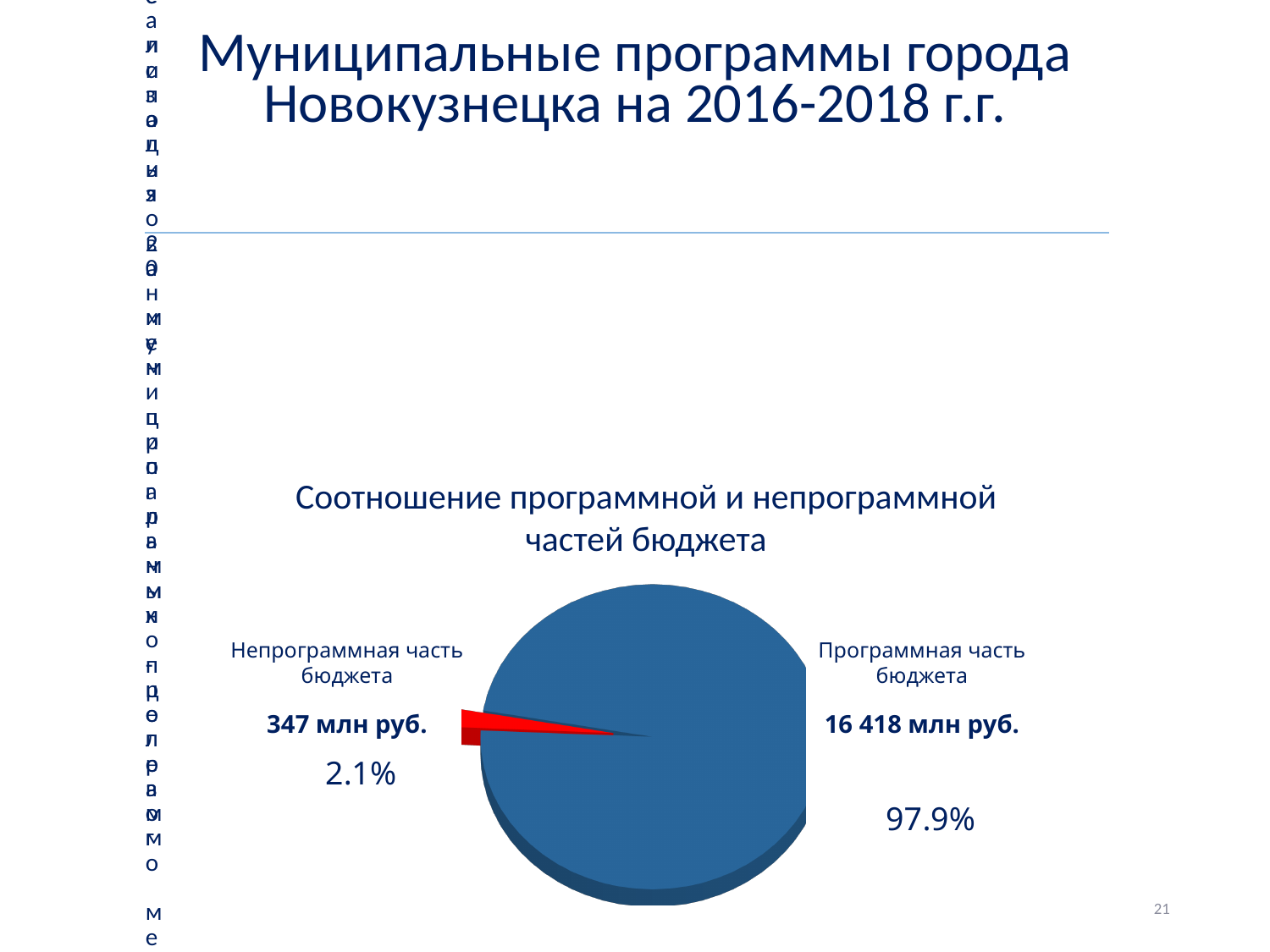
What is the value for Программная часть бюджета? 16 418 млн руб. What is the value for Непрограммная часть бюджета? 347 млн руб. What share of the pie does Программная часть бюджета represent? 97.9% What is the title of the chart? Соотношение программной и непрограммной частей бюджета How many slices does the pie chart have? 2 Which is larger, Программная часть бюджета or Непрограммная часть бюджета? Программная часть бюджета What kind of chart is shown on the slide? pie chart Which slice is the smallest? Непрограммная часть бюджета What colour is the slice for Непрограммная часть бюджета? red What share of the pie does Непрограммная часть бюджета represent? 2.1% What is the difference between Программная часть бюджета and Непрограммная часть бюджета? 16 071 млн руб. Which slice is the largest? Программная часть бюджета